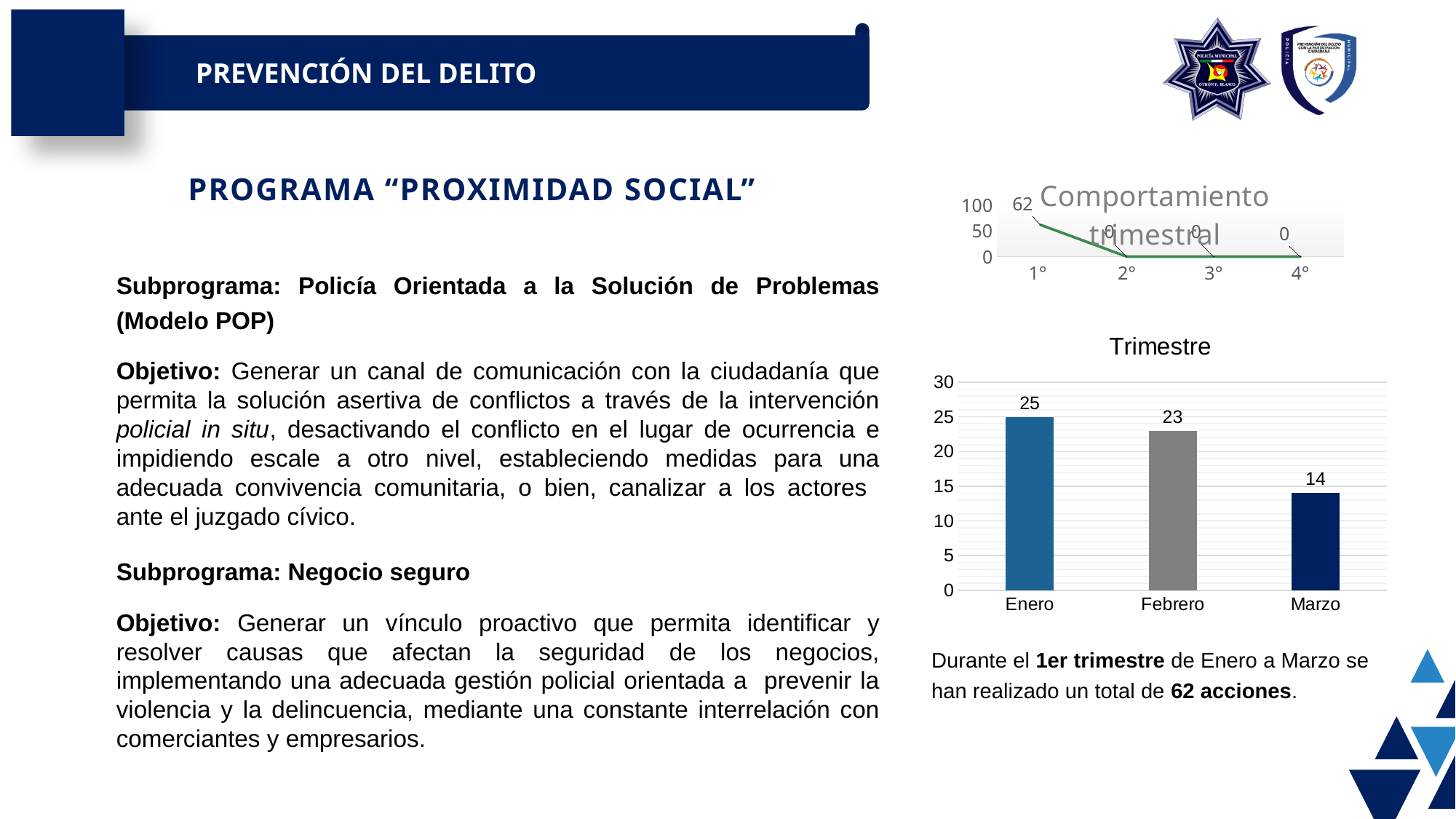
What kind of chart is the "Comportamiento trimestral" chart? Line chart In the "Comportamiento trimestral" chart, what is the value for 1°? 62 In the "Trimestre" chart, what is the difference between the values for Enero and Marzo? 11 In the "Trimestre" chart, which month has the lowest value? Marzo In the "Trimestre" chart, which month has the highest value? Enero In the "Trimestre" chart, what is the value for Enero? 25 What kind of chart is the "Trimestre" chart? Bar chart In the "Trimestre" chart, what is the value for Marzo? 14 In the "Trimestre" chart, do the values rise or fall from Enero to Marzo? Fall In the "Trimestre" chart, how many months are shown? 3 In the "Trimestre" chart, which is larger, the value for Febrero or the value for Marzo? Febrero In the "Trimestre" chart, what is the value for Febrero? 23